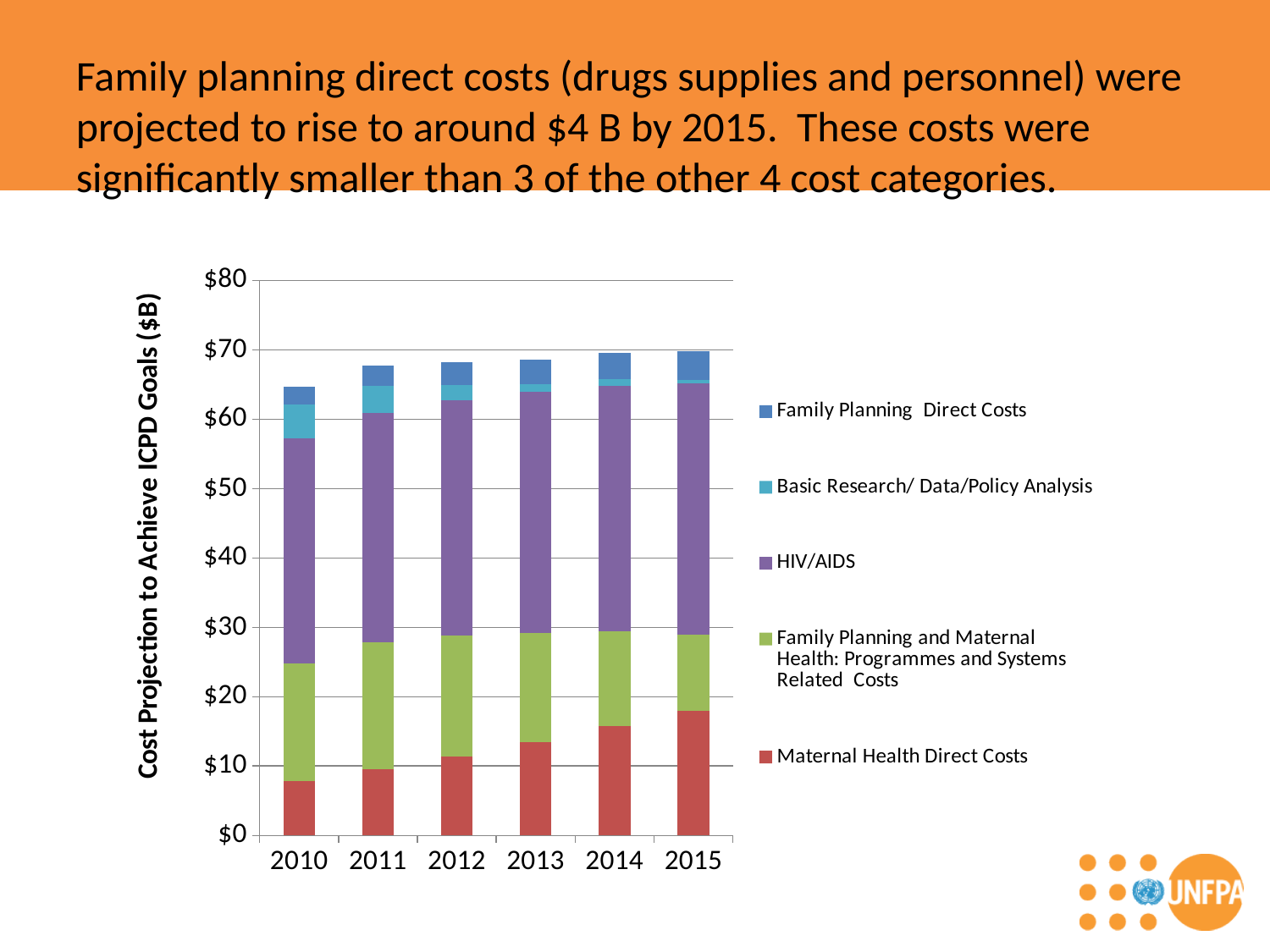
Is the total stacked value for 2012 greater or less than $60? greater Is the Maternal Health Direct Costs value for 2010 greater or less than $10? less Is the total stacked value for 2010 greater or less than $70? less Is the Maternal Health Direct Costs value larger in 2010 or in 2015? 2015 What is the title of the chart's vertical axis? Cost Projection to Achieve ICPD Goals ($B) Which year has the lowest total stacked bar? 2010 How many years are shown along the x axis of the chart? 6 What kind of chart is shown on the slide? Stacked bar chart How many series does the chart's legend list? 5 Which year has the largest Maternal Health Direct Costs segment? 2015 Do the total stacked bar heights rise or fall from 2010 to 2015? rise